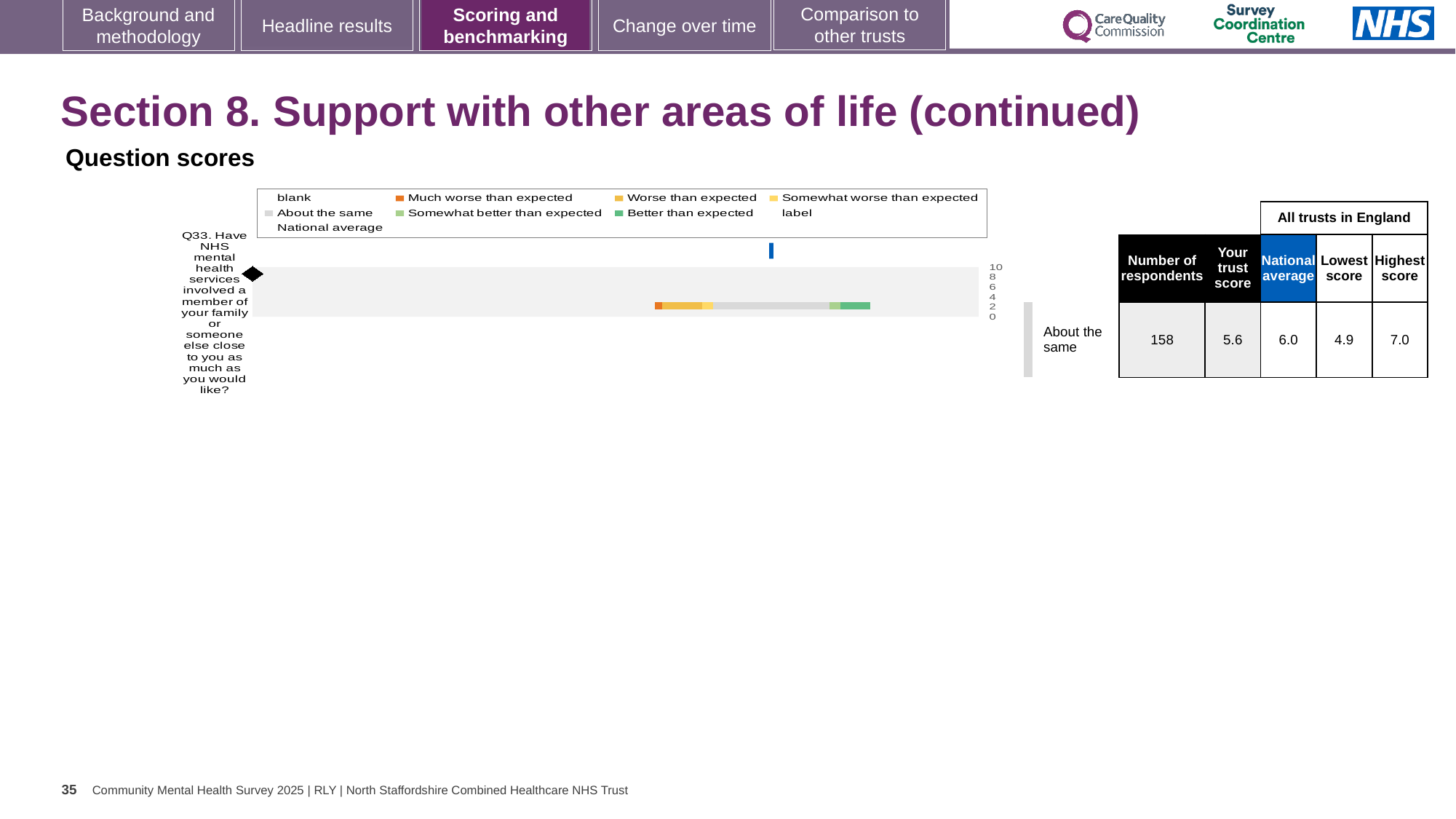
How many survey questions are plotted on the chart? 1 How much higher is the national average than the trust score for Q33? 0.4 What is the trust score for Q33 (involving a family member or someone close as much as you would like)? 5.6 Is the trust score for Q33 greater or less than 6? less Which is larger for Q33, the trust score or the national average? National average What is the difference between the highest and lowest trust scores for Q33? 2.1 Which benchmarking category is the trust's Q33 score placed in? About the same How many respondents answered Q33? 158 What is the highest score among all trusts in England for Q33? 7.0 What is the national average score for Q33? 6.0 What is the lowest score among all trusts in England for Q33? 4.9 What kind of chart is used to show the Q33 score? Bar chart